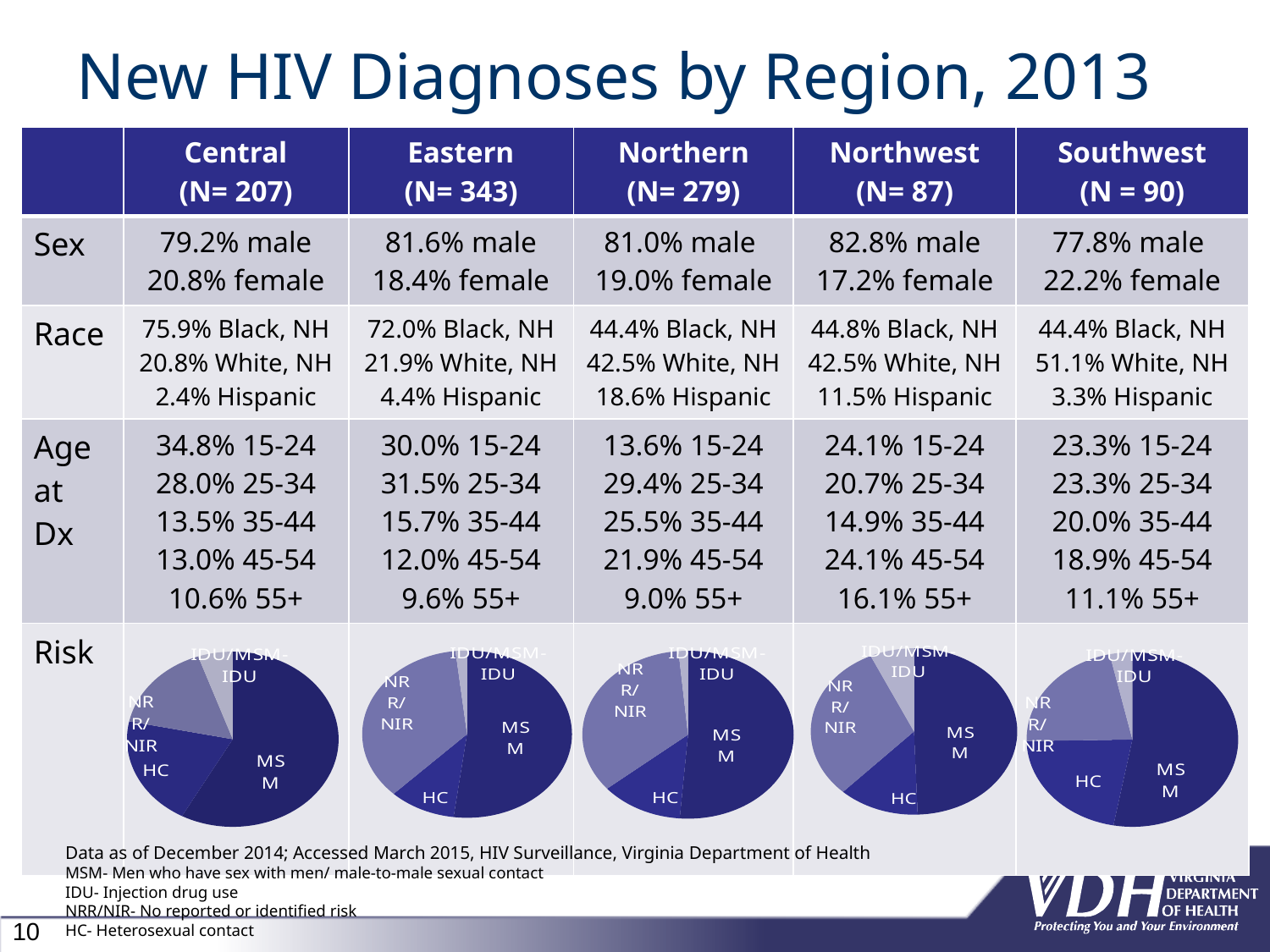
In the Eastern pie chart, which risk category has the largest slice? MSM In the Central pie chart, which slice is larger, MSM or HC? MSM According to the footnote, what does the HC slice in the pie charts stand for? Heterosexual contact According to the footnote, what does the IDU slice in the pie charts stand for? Injection drug use In the Central pie chart, which risk category has the largest slice? MSM In the Southwest pie chart, which slice is larger, HC or IDU? HC In the Central pie chart, how many risk categories (slices) are shown? 4 How many pie charts are shown in the Risk row? 5 In the Northwest pie chart, which risk category has the largest slice? MSM What kind of chart is used in the Risk row of the table? Pie chart